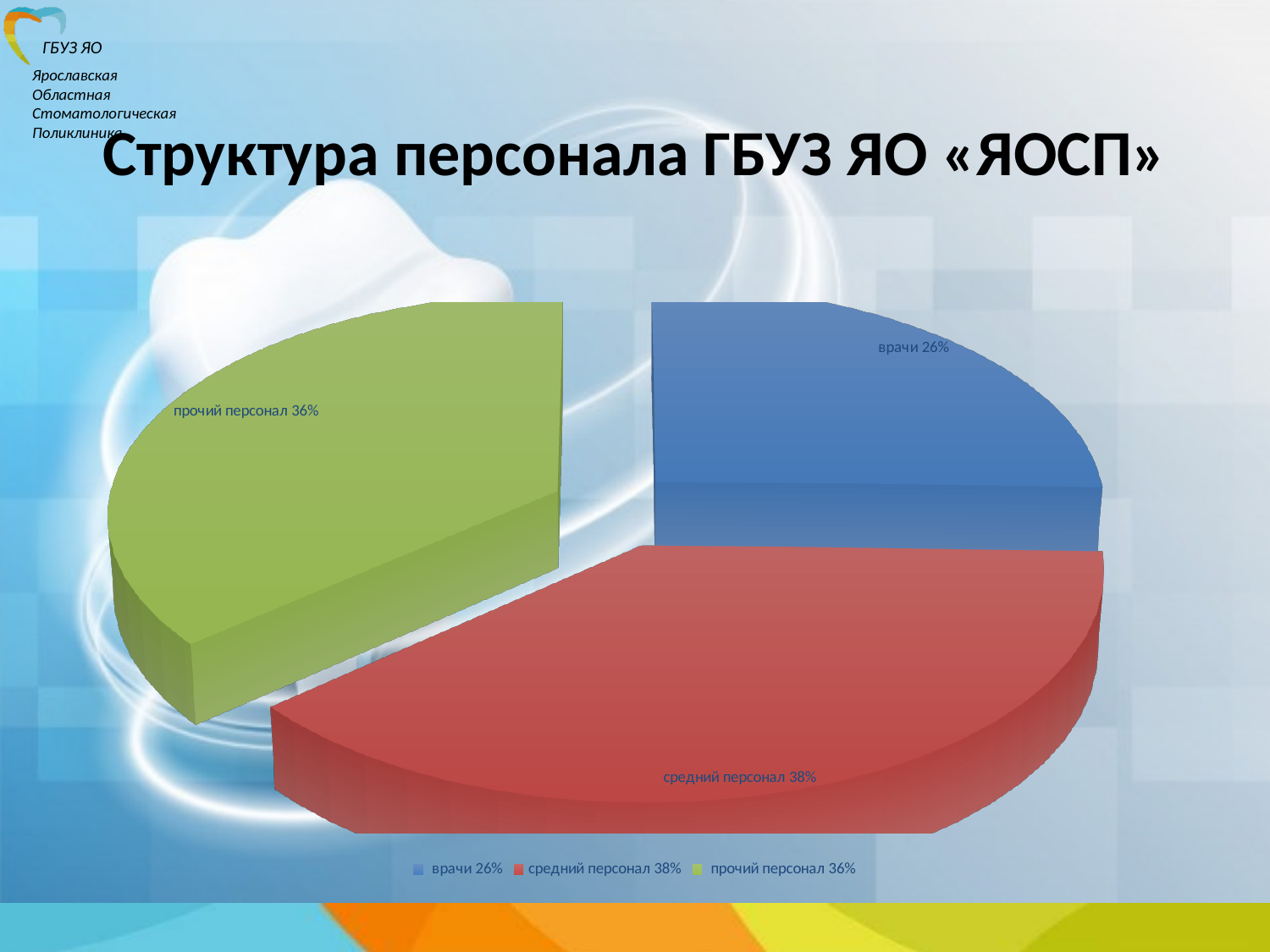
What is the difference in percentage points between средний персонал and врачи? 12 What is the difference in percentage points between прочий персонал and врачи? 10 What share of the pie does прочий персонал have? 36% What colour is the slice for средний персонал? red Which category has the smallest share of the pie? врачи Which category has the largest share of the pie? средний персонал How many slices does the pie chart have? 3 Which is larger, the share for прочий персонал or the share for врачи? прочий персонал What is the title of the chart on the slide? Структура персонала ГБУЗ ЯО «ЯОСП» What share of the pie does средний персонал have? 38% What share of the pie does врачи have? 26% What kind of chart is shown on the slide? pie chart